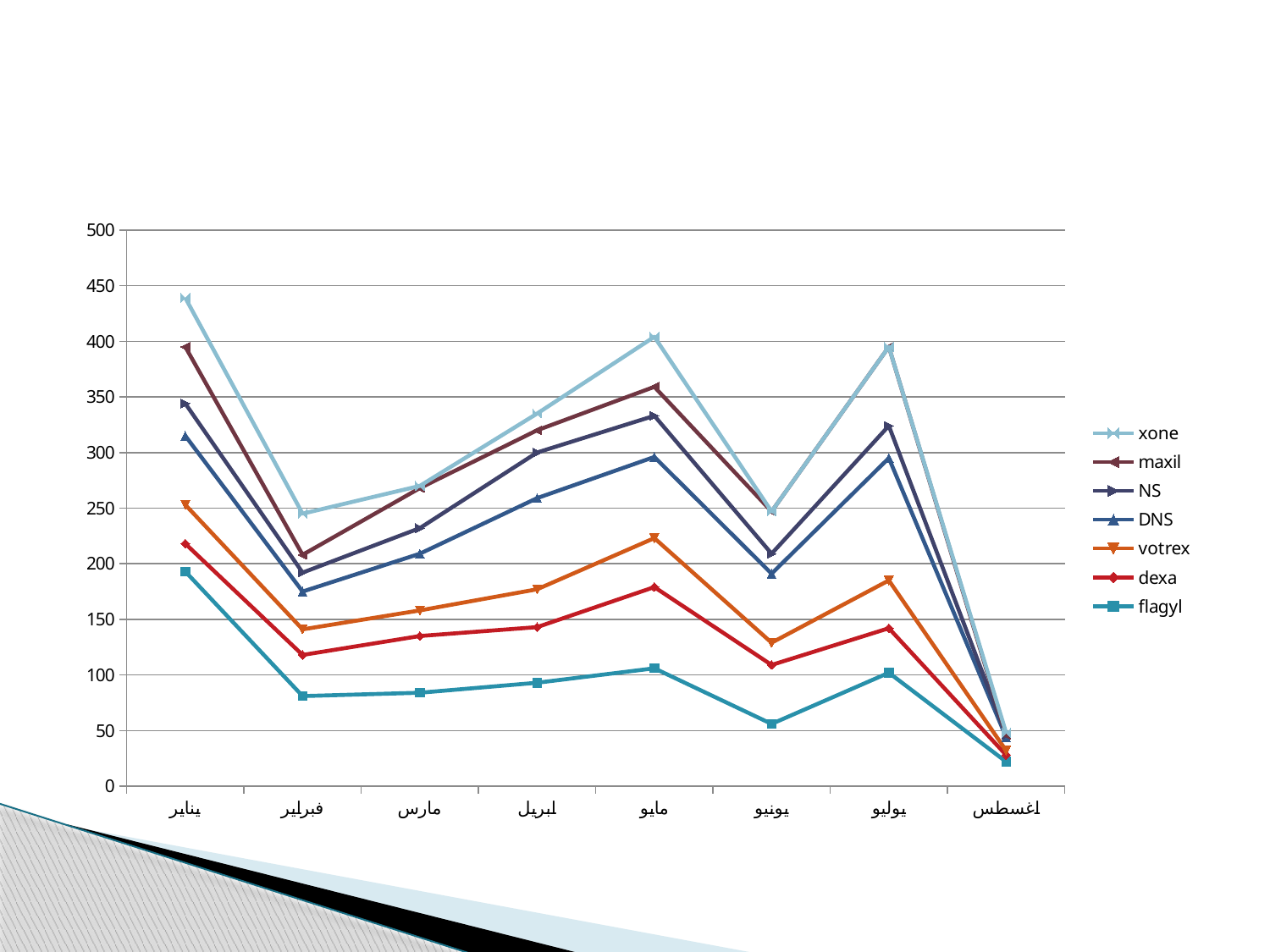
In مايو, which series has the higher value, xone or maxil? xone How many categories are shown along the x axis? 8 Does the flagyl series rise or fall from فبراير to مايو? rise Which series is listed first in the legend? xone In يناير, which series has the higher value, votrex or dexa? votrex Is the value for flagyl in فبراير greater or less than 100? less How many series does the legend list? 7 What kind of chart is shown on the slide? Line chart In which month does the flagyl series reach its lowest value? اغسطس